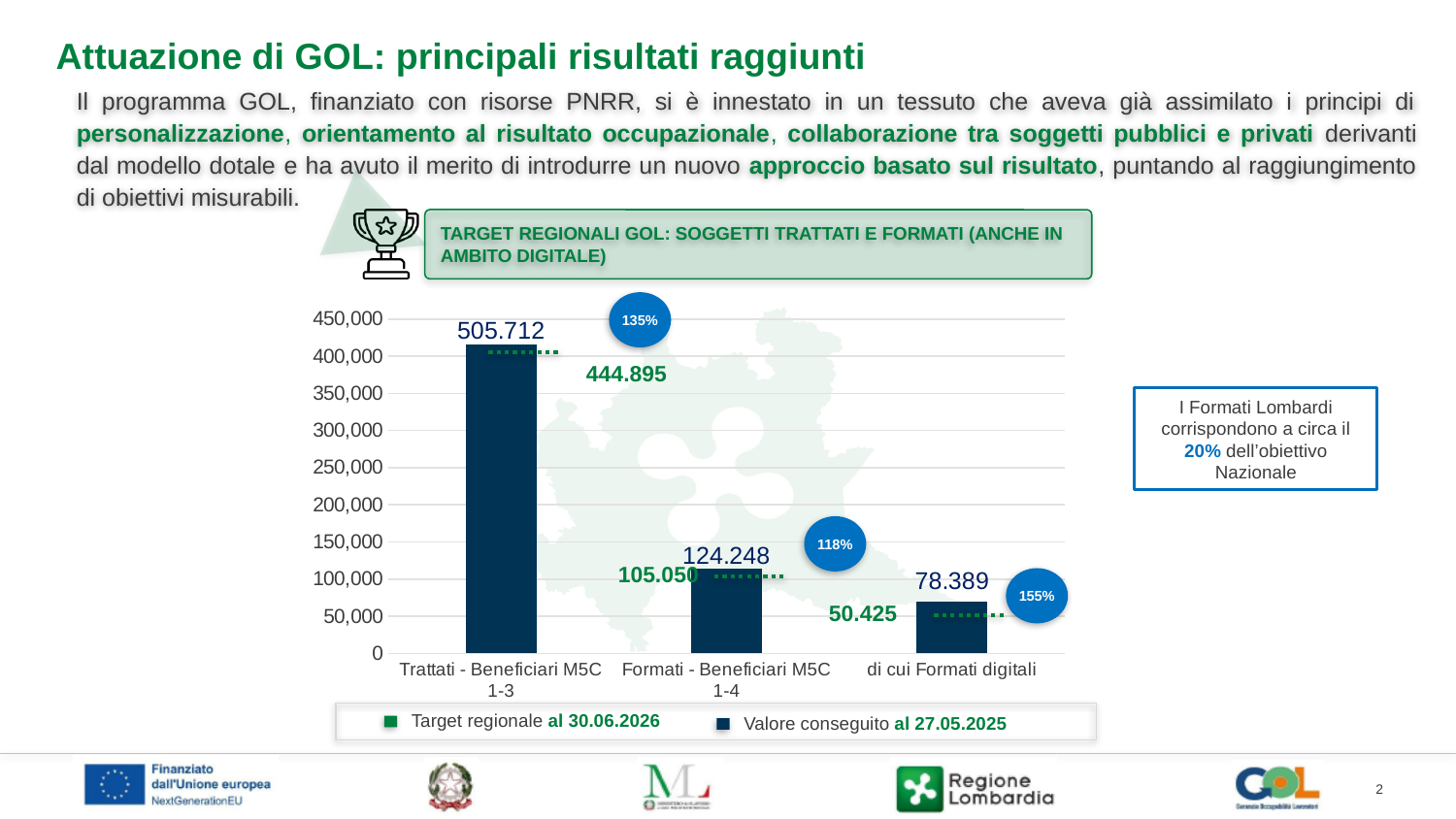
What percentage of the target is shown for Formati - Beneficiari M5C 1-4? 118% What is the achieved value for di cui Formati digitali? 78.389 What is the achieved value (Valore conseguito al 27.05.2025) for Trattati - Beneficiari M5C 1-3? 505.712 What kind of chart is shown on the slide? Bar chart How many series does the chart legend list? 2 Which category has the lowest regional target? di cui Formati digitali How many categories are shown on the x axis of the chart? 3 By how much does the achieved value for Trattati - Beneficiari M5C 1-3 exceed its regional target of 444.895? 60.817 What is the regional target for di cui Formati digitali? 50.425 Which is larger: the achieved value for Formati - Beneficiari M5C 1-4 or the achieved value for di cui Formati digitali? Formati - Beneficiari M5C 1-4 Which category has the highest achieved value? Trattati - Beneficiari M5C 1-3 What is the regional target (Target regionale al 30.06.2026) for Formati - Beneficiari M5C 1-4? 105.050